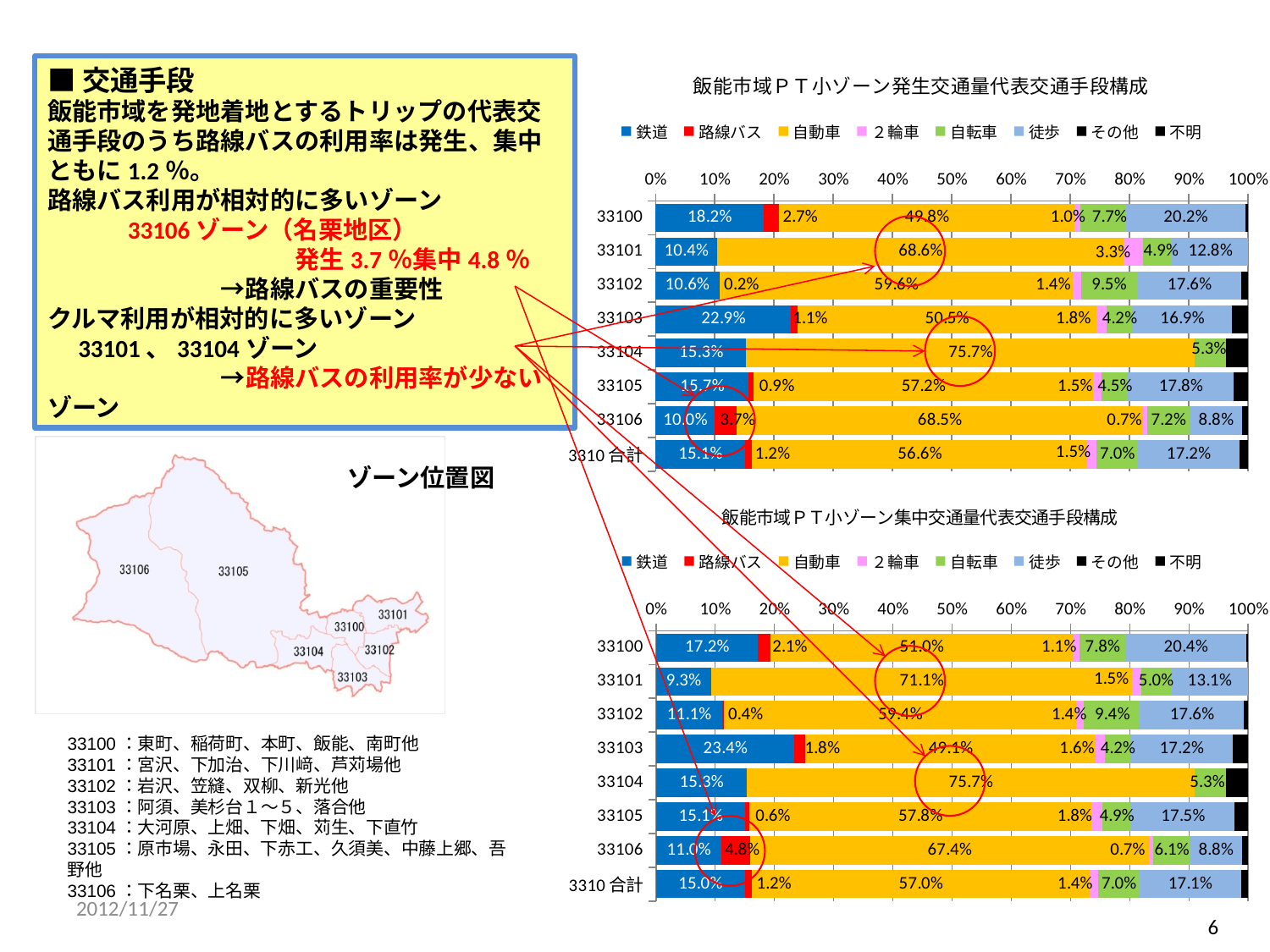
In the bottom chart, which zone has the lowest 鉄道 share? 33101 In the top chart, what is the difference between the 自動車 share of zone 33101 and that of zone 33100? 18.8% In the bottom chart, what is the 鉄道 share for zone 33103? 23.4% In the bottom chart, what is the 路線バス share for 3310合計? 1.2% In the top chart, which zone has the highest 鉄道 share? 33103 What type of chart is the top chart? Stacked bar chart How many zone categories are plotted in the top chart? 8 In the bottom chart, which is larger: the 徒歩 share for zone 33100 or for zone 33106? 33100 In the top chart, what is the 自動車 share for zone 33104? 75.7% In the top chart (飯能市域ＰＴ小ゾーン発生交通量代表交通手段構成), what is the 路線バス share for zone 33106? 3.7% In the bottom chart (飯能市域ＰＴ小ゾーン集中交通量代表交通手段構成), what is the 路線バス share for zone 33106? 4.8% How many series does the legend of the bottom chart list? 8